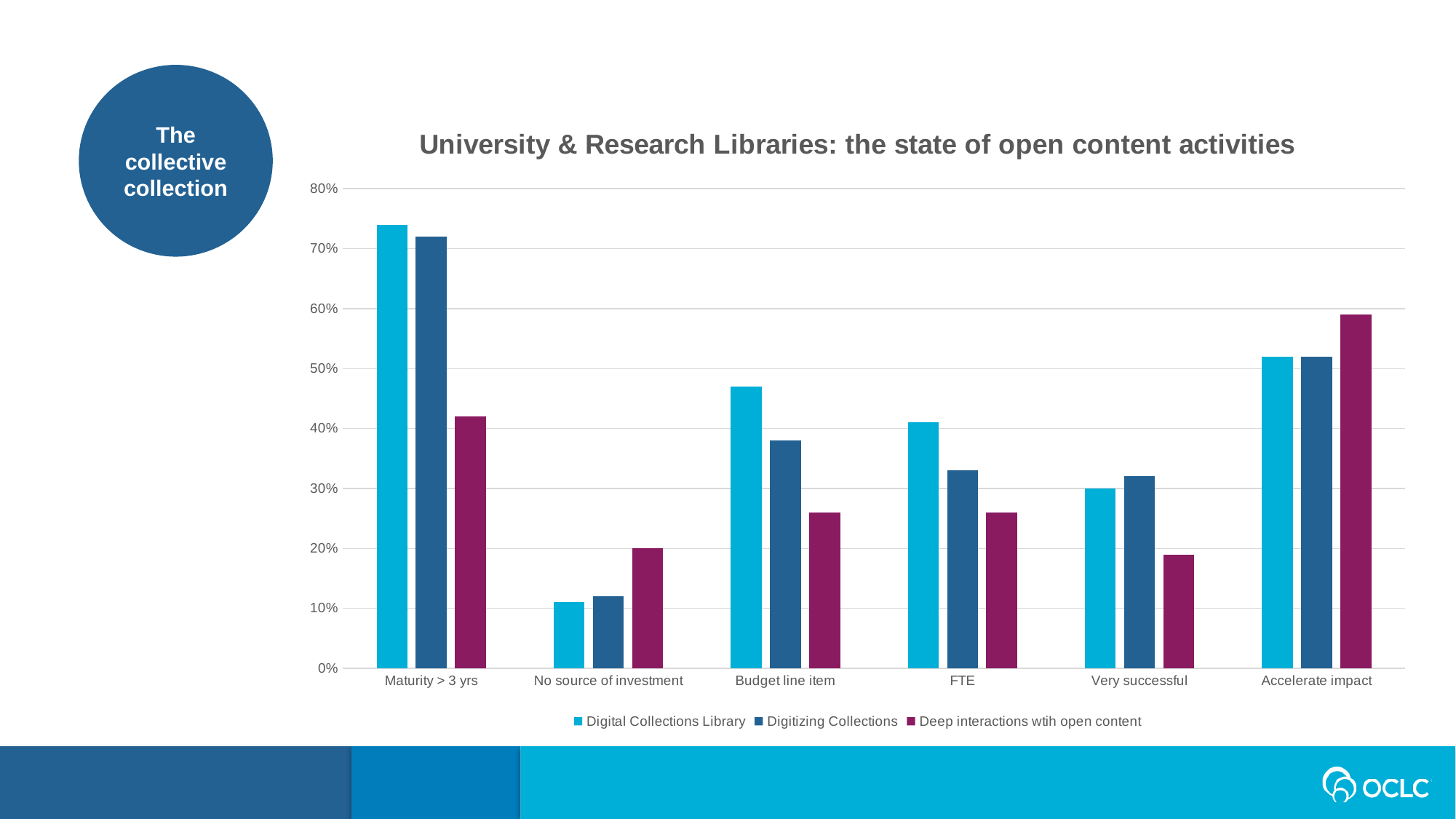
What is the title of the chart? University & Research Libraries: the state of open content activities How many series does the legend list? 3 At Budget line item, which is larger: Digital Collections Library or Digitizing Collections? Digital Collections Library How many categories are shown along the x axis? 6 Is the value for Digital Collections Library at Maturity > 3 yrs greater or less than 70%? greater Is the value for Digitizing Collections at Budget line item greater or less than 40%? less Is the value for Deep interactions wtih open content at Accelerate impact greater or less than 50%? greater What kind of chart is shown on the slide? bar chart For the Digital Collections Library series, which category has the highest value? Maturity > 3 yrs For the Deep interactions wtih open content series, which category has the highest value? Accelerate impact For the Digital Collections Library series, which category has the lowest value? No source of investment